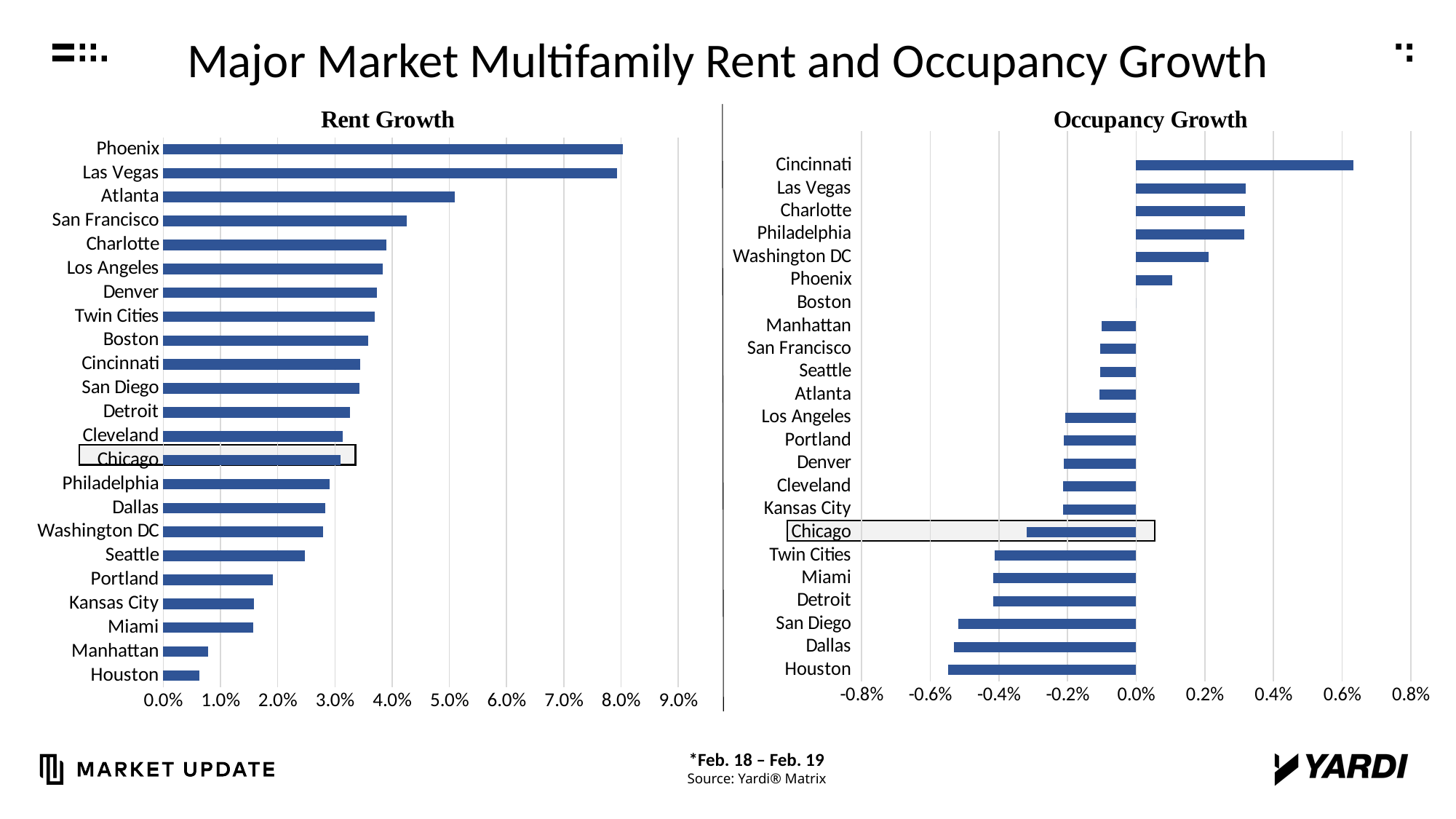
In the Rent Growth chart, is the value for Houston greater or less than 1.0%? less What type of chart is the Occupancy Growth chart? Bar chart In the Rent Growth chart, is the value for Phoenix greater or less than 7.0%? greater In the Occupancy Growth chart, is the value for Chicago greater or less than -0.2%? less In the Occupancy Growth chart, which city has the lowest occupancy growth? Houston In the Rent Growth chart, which city has the lowest rent growth? Houston In the Rent Growth chart, which city has the highest rent growth? Phoenix How many cities are shown in the Rent Growth chart? 23 In the Occupancy Growth chart, which city has the highest occupancy growth? Cincinnati In the Rent Growth chart, which has higher rent growth, Phoenix or Atlanta? Phoenix In the Occupancy Growth chart, which has lower occupancy growth, San Diego or Twin Cities? San Diego